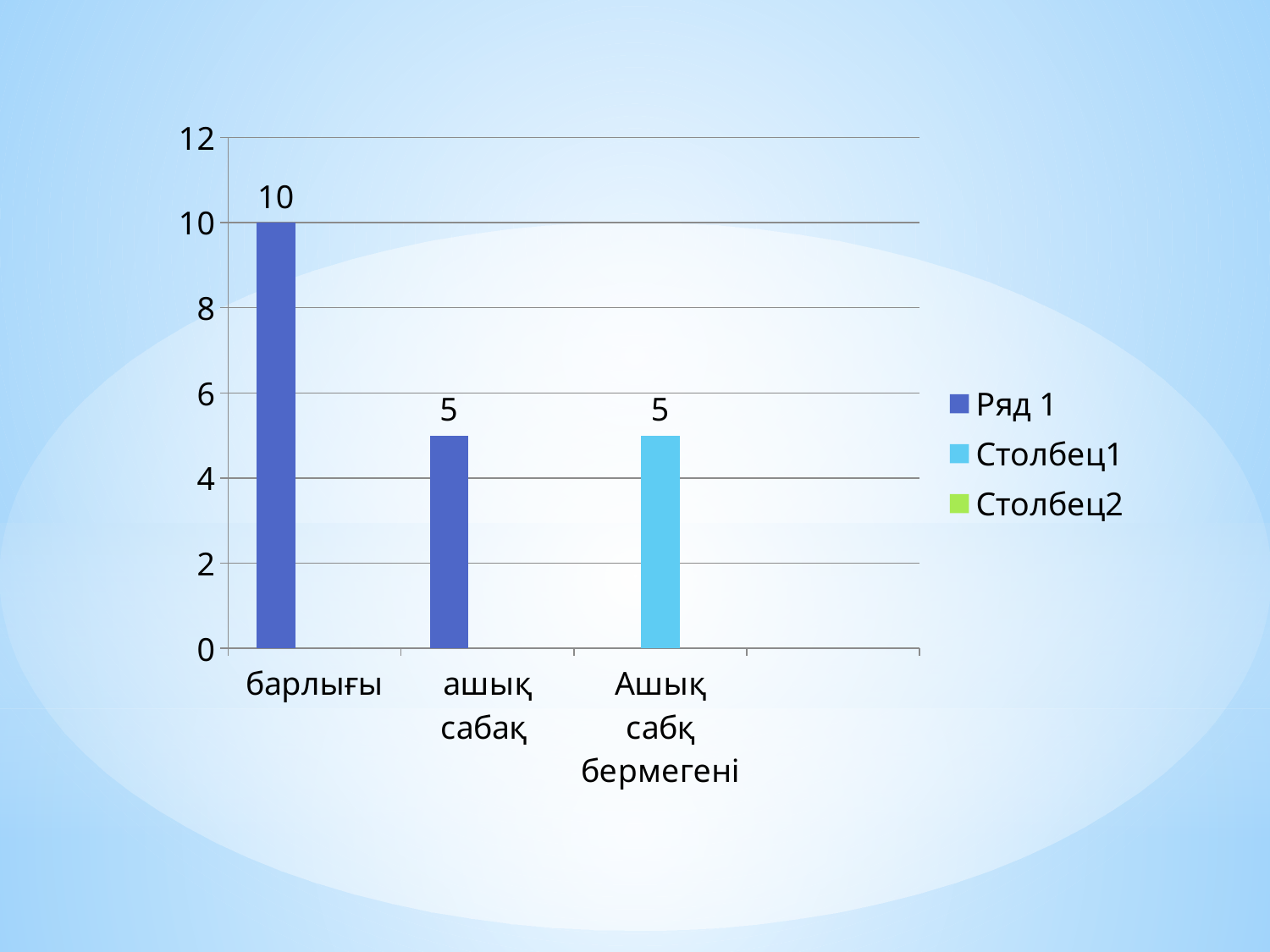
Is the value for барлығы greater or less than 8? greater What is the value for ашық сабақ? 5 Is the value for ашық сабақ greater or less than 6? less What is the value for барлығы? 10 Which category has the highest value? барлығы What is the value for Ашық сабқ бермегені? 5 What is the difference between the values for барлығы and ашық сабақ? 5 What is the maximum value shown on the vertical axis? 12 How many categories are shown on the x axis? 3 Which is larger, the value for барлығы or the value for Ашық сабқ бермегені? барлығы How many series does the legend list? 3 What kind of chart is shown on the slide? bar chart